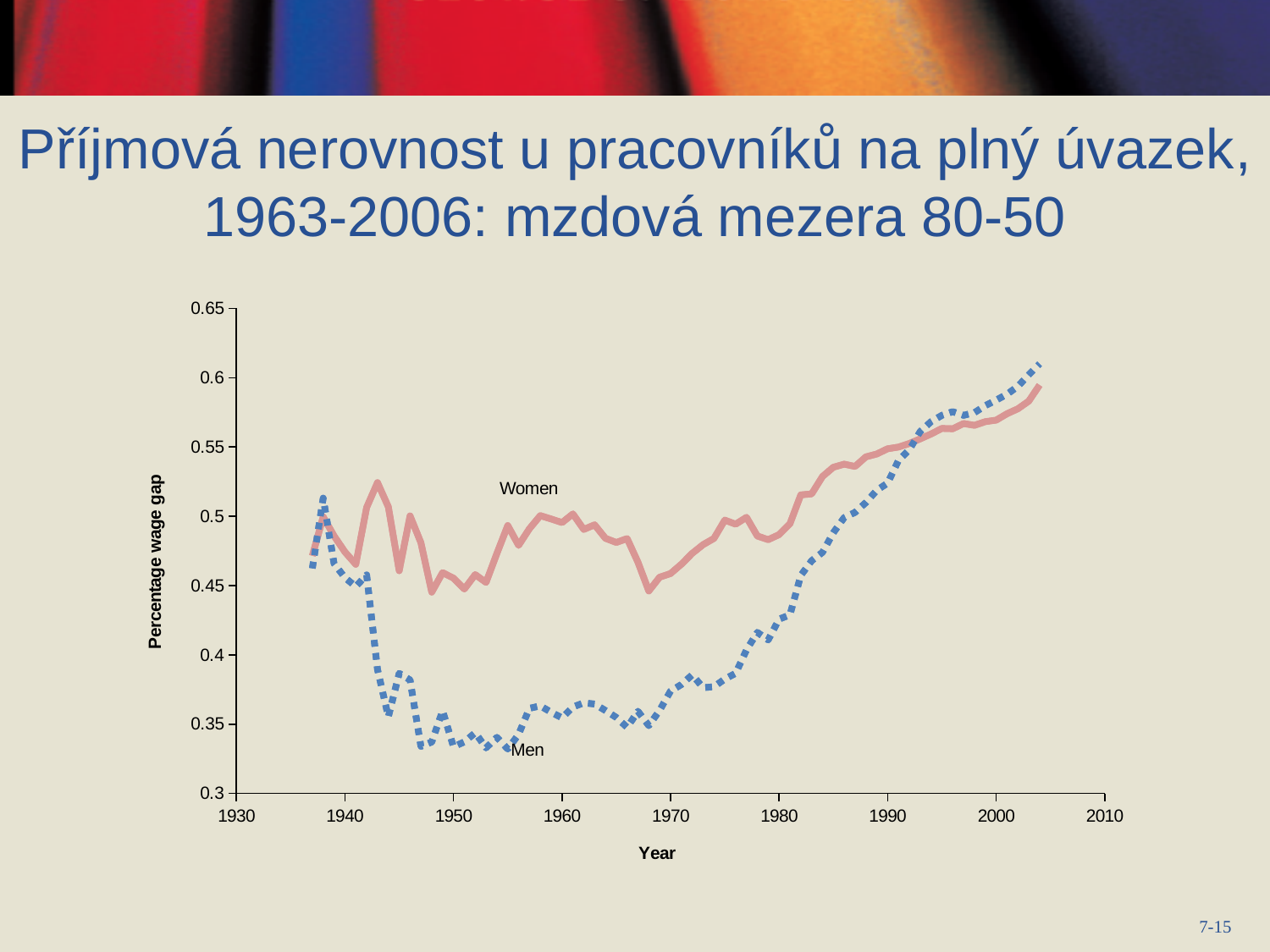
Is the value for Women around 1960 greater or less than 0.45? greater How many data series are plotted on the chart? 2 Is the value for Men around 1980 greater or less than 0.45? less Is the value for Women around 2000 greater or less than 0.55? greater Does the Men series rise or fall between 1940 and 1950? fall What is the title of the vertical axis of the chart? Percentage wage gap What kind of chart is shown on the slide? line chart Which series reaches the lowest value shown on the chart? Men What is the title of the horizontal axis of the chart? Year Does the Men series rise or fall between 1970 and 2000? rise Around 1960, which series has the higher value, Women or Men? Women